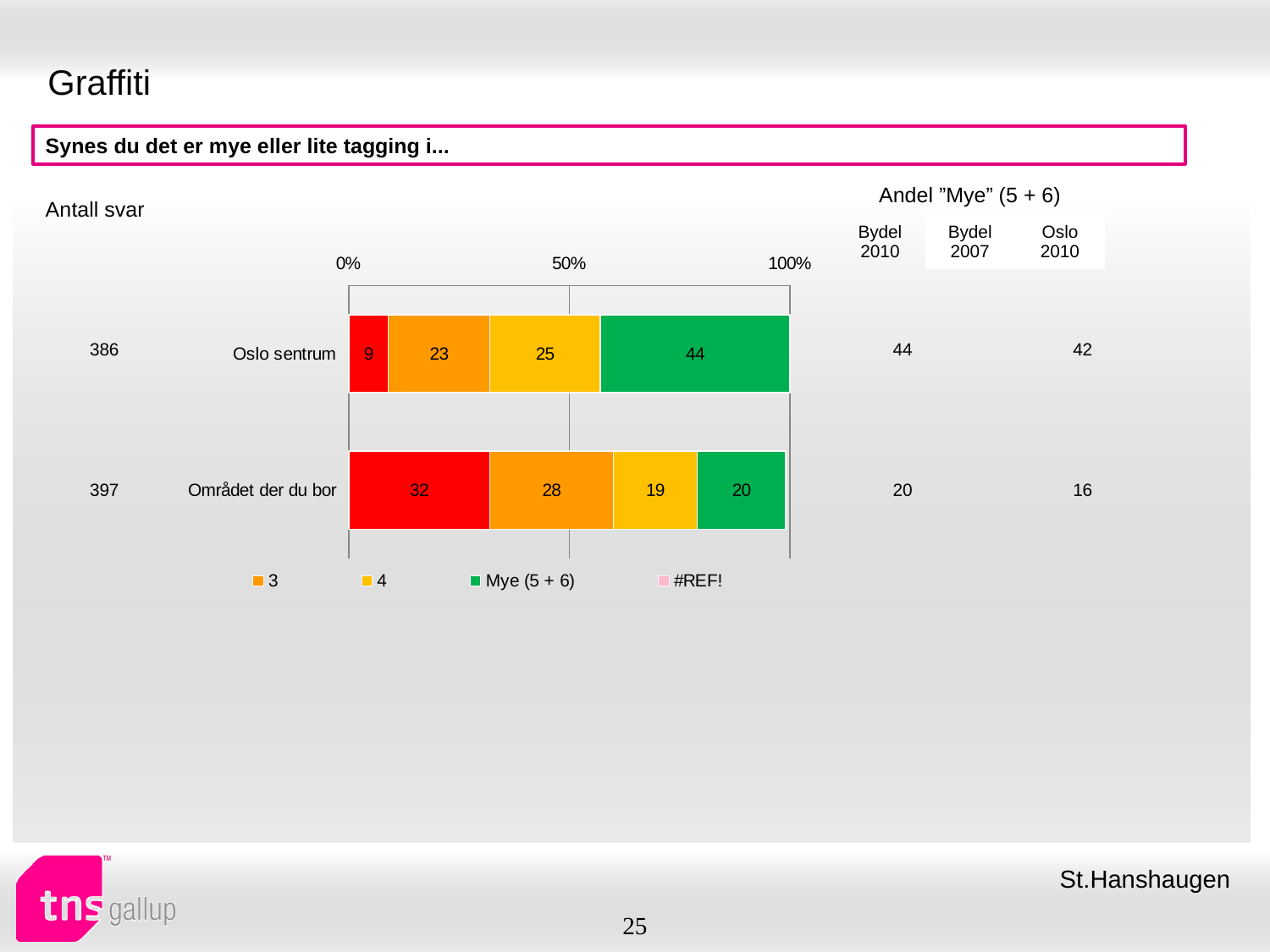
What is the total of the labelled segments in the Området der du bor bar? 99 What is the value of the "3" segment for Oslo sentrum? 23 How many entries does the chart legend list? 4 What kind of chart is shown on the slide? Stacked bar chart What is the value of the "Mye (5 + 6)" segment for Området der du bor? 20 What question text is shown in the box above the chart? Synes du det er mye eller lite tagging i... How many categories are shown in the bar chart? 2 What is the value of the "Mye (5 + 6)" segment for Oslo sentrum? 44 What is the difference between the "Mye (5 + 6)" values for Oslo sentrum and Området der du bor? 24 What is the value of the "4" segment for Området der du bor? 19 Which category has the highest value for the "3" segment? Området der du bor Which category has the larger "Mye (5 + 6)" segment, Oslo sentrum or Området der du bor? Oslo sentrum